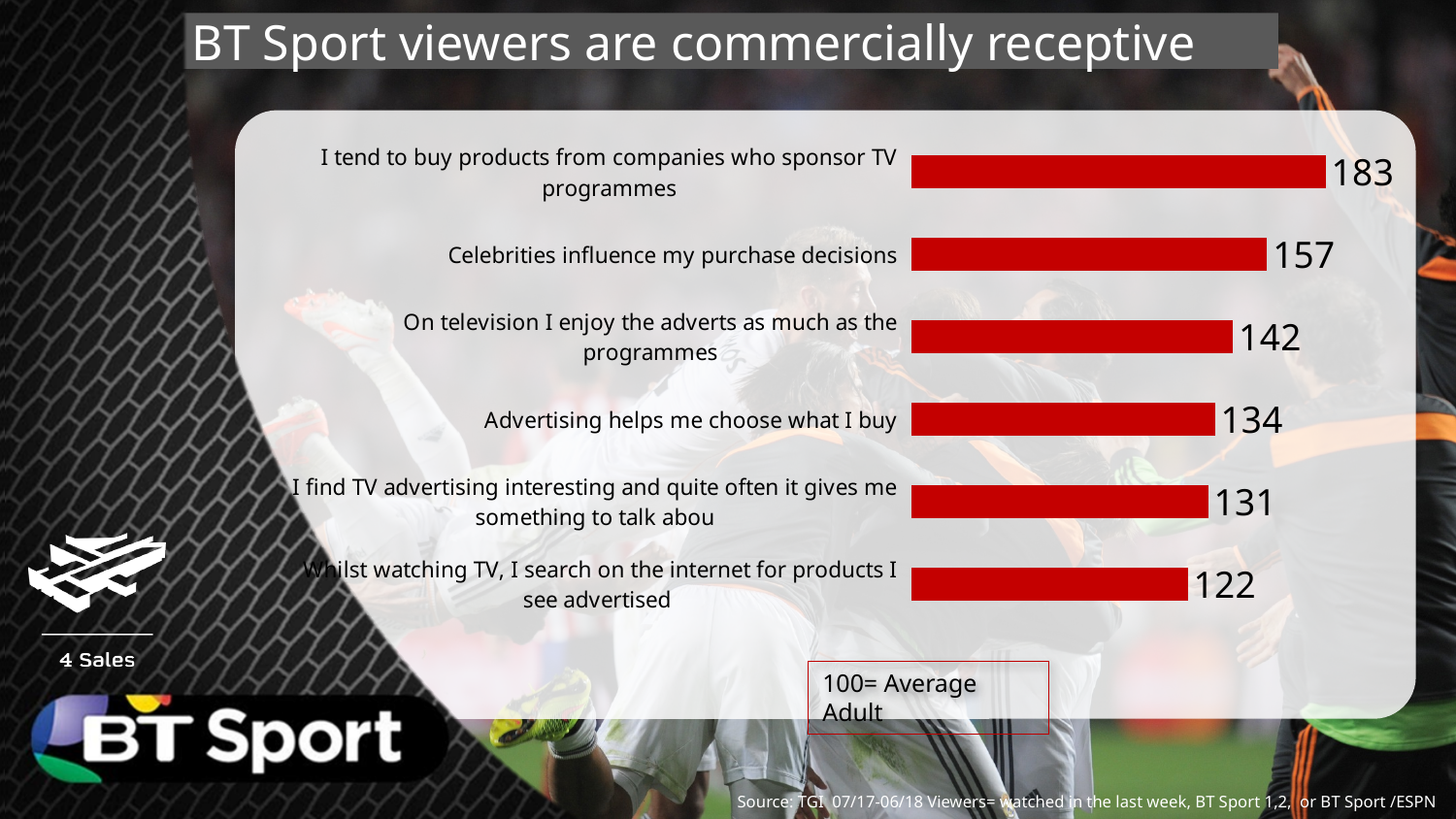
What is the value for "Whilst watching TV, I search on the internet for products I see advertised"? 122 How many statements are shown in the chart? 6 Which statement has the highest value? I tend to buy products from companies who sponsor TV programmes Which has a larger value: "Advertising helps me choose what I buy" or "I find TV advertising interesting and quite often it gives me something to talk abou"? Advertising helps me choose what I buy What is the value for "Celebrities influence my purchase decisions"? 157 What is the value for "Advertising helps me choose what I buy"? 134 Which statement has the lowest value? Whilst watching TV, I search on the internet for products I see advertised What does a value of 100 represent according to the note on the slide? Average Adult What is the difference between the values for "On television I enjoy the adverts as much as the programmes" and "Whilst watching TV, I search on the internet for products I see advertised"? 20 What is the difference between the values for "I tend to buy products from companies who sponsor TV programmes" and "Celebrities influence my purchase decisions"? 26 What colour are the bars in the chart? Red What kind of chart is shown on the slide? Bar chart